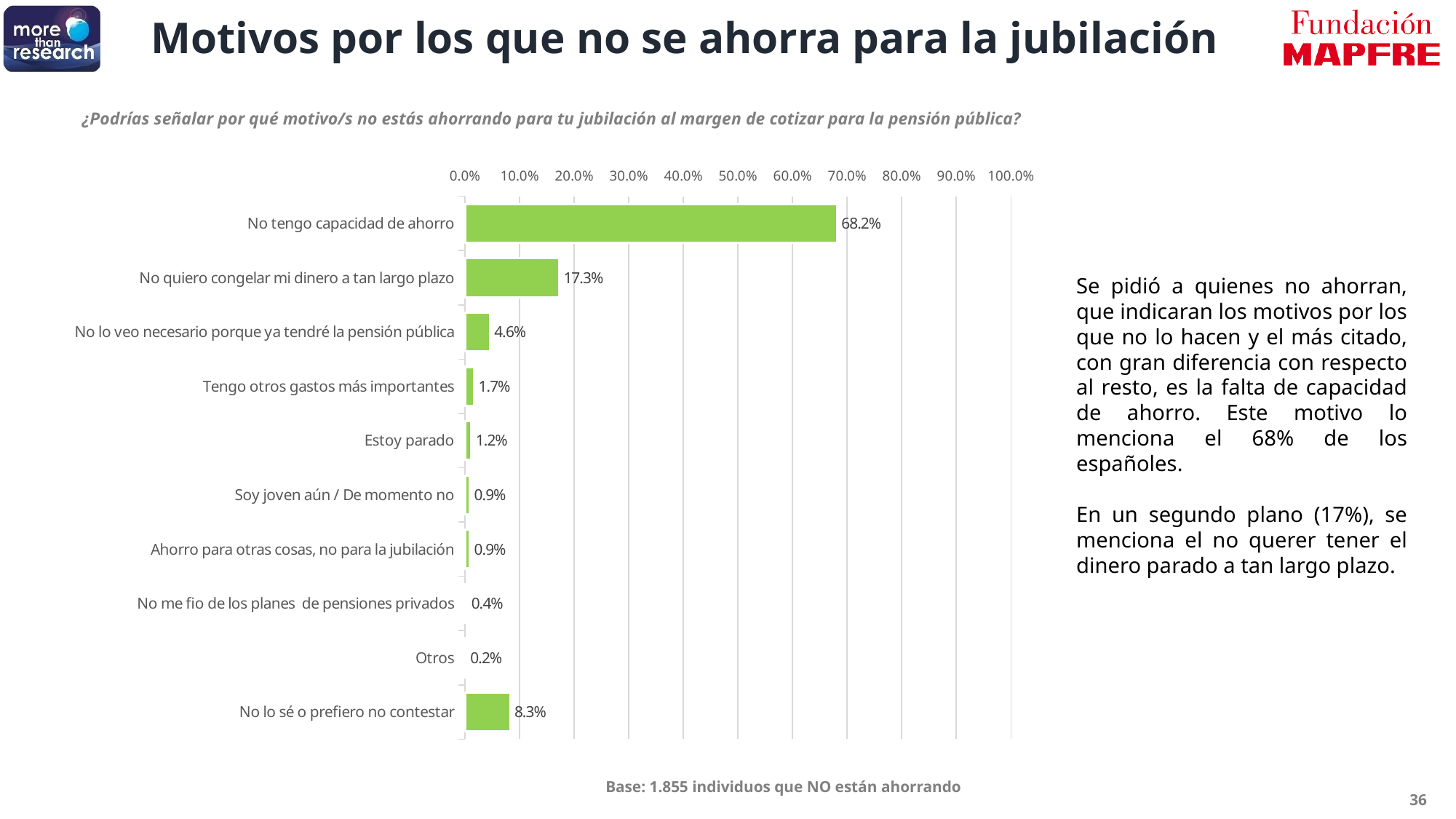
What is the base (number of individuals) stated below the chart? 1.855 individuos que NO están ahorrando Which is larger: "No lo veo necesario porque ya tendré la pensión pública" or "No lo sé o prefiero no contestar"? No lo sé o prefiero no contestar How many categories are shown in the chart? 10 What kind of chart is shown on the slide? Bar chart What is the value for "No tengo capacidad de ahorro"? 68.2% What is the value for "No lo sé o prefiero no contestar"? 8.3% Which category has the lowest value? Otros What is the value for "Estoy parado"? 1.2% Is the value for "No tengo capacidad de ahorro" greater or less than 60.0%? greater What is the value for "No quiero congelar mi dinero a tan largo plazo"? 17.3% Which category has the highest value? No tengo capacidad de ahorro What is the difference between "No tengo capacidad de ahorro" and "No quiero congelar mi dinero a tan largo plazo"? 50.9%